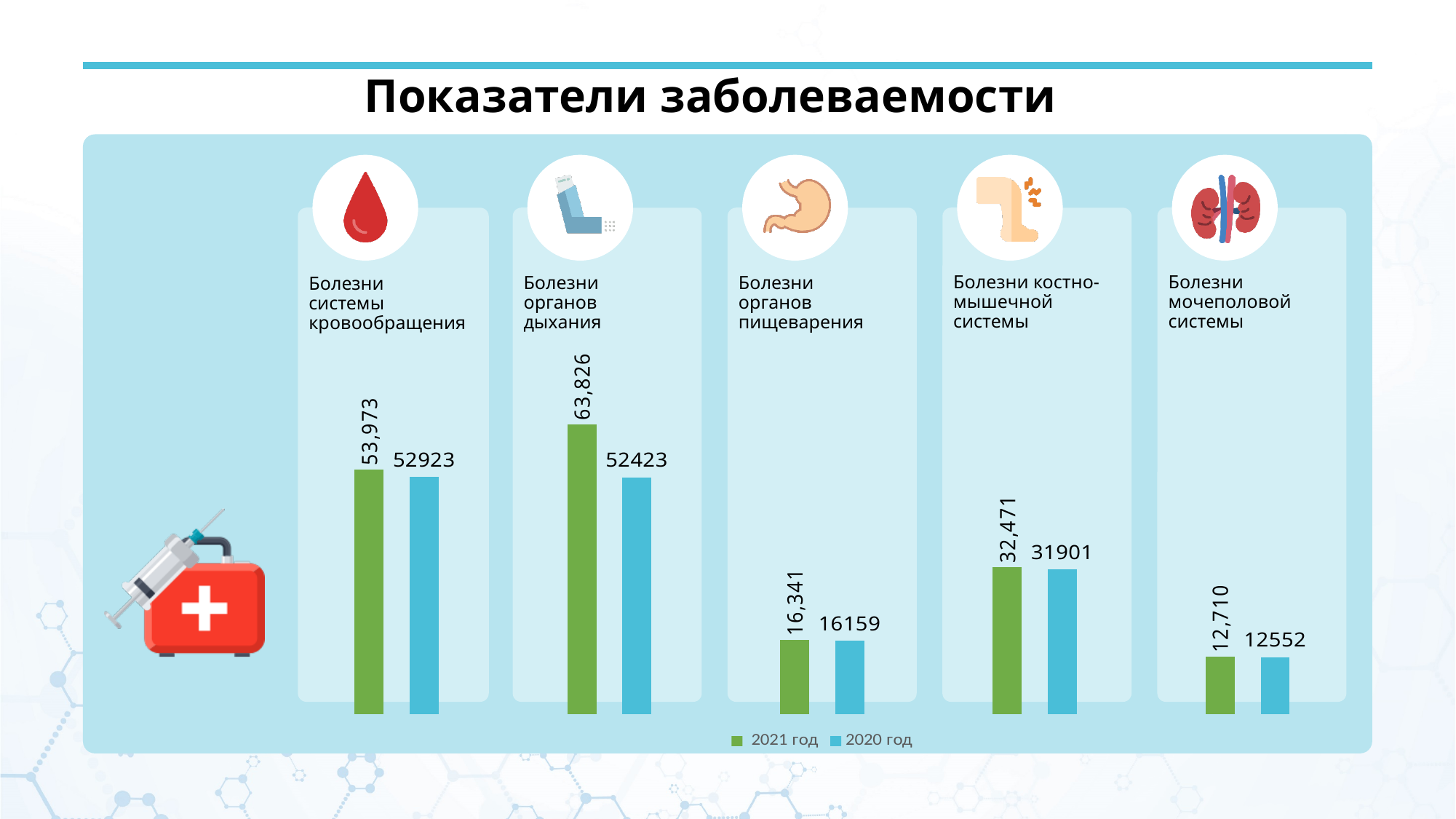
Which is larger for Болезни органов пищеварения: the 2021 год value or the 2020 год value? 2021 год How many series does the legend list? 2 What is the 2021 год value for Болезни мочеполовой системы? 12,710 What is the difference between the 2021 год and 2020 год values for Болезни органов дыхания? 11403 What type of chart is shown on the slide? Bar chart What is the difference between the 2021 год and 2020 год values for Болезни системы кровообращения? 1050 Which category has the lowest 2020 год value? Болезни мочеполовой системы What is the 2020 год value for Болезни костно-мышечной системы? 31901 Which category has the highest 2021 год value? Болезни органов дыхания What is the 2020 год value for Болезни системы кровообращения? 52923 How many disease categories are shown in the chart? 5 What is the 2021 год value for Болезни органов дыхания? 63,826